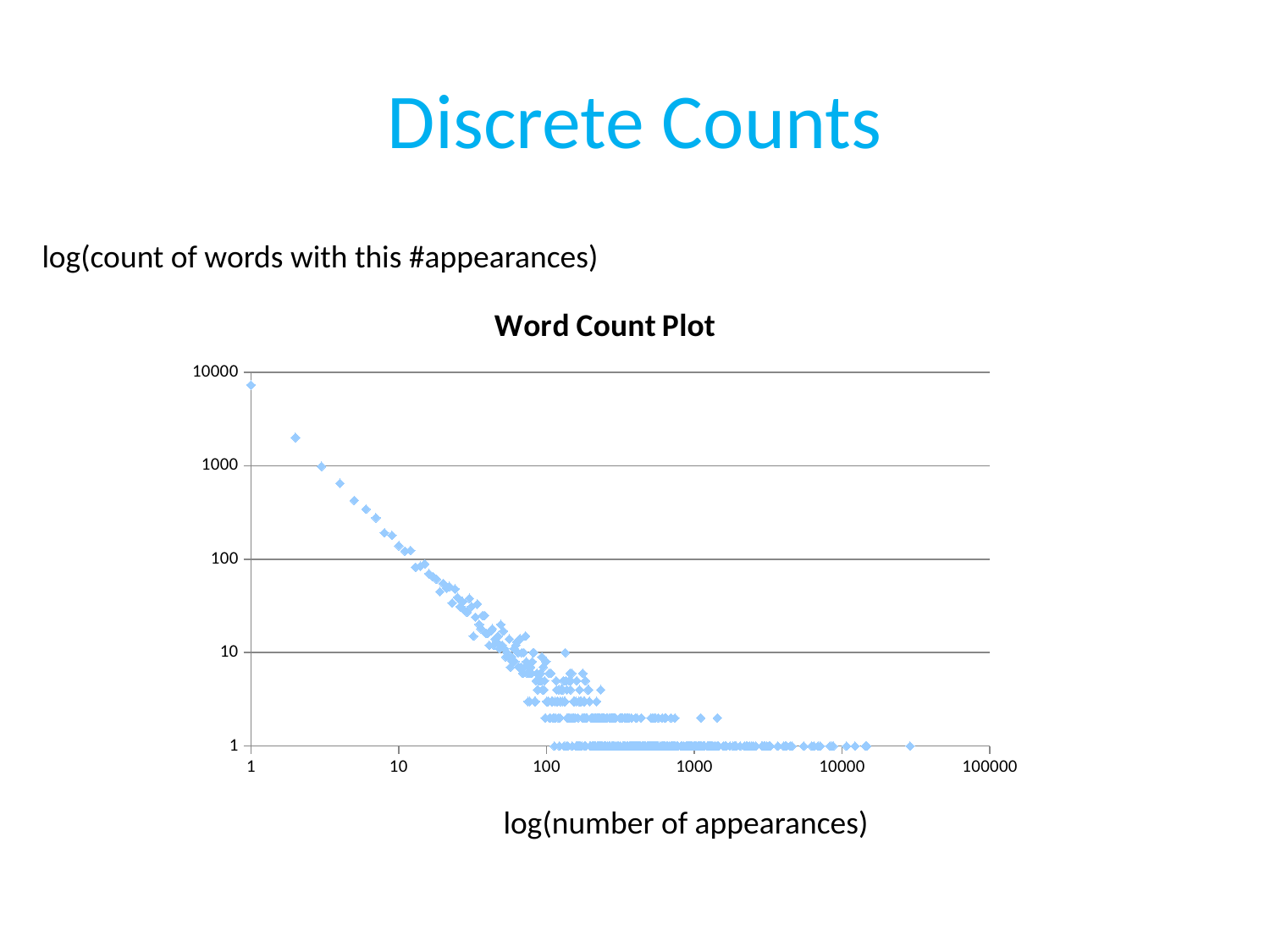
Which x value has the highest plotted count? 1 What is the label on the horizontal axis of the chart? log(number of appearances) Is the value for 1 appearance greater or less than 1000? greater Is the value for 10 appearances greater or less than 100? greater Is the value for 2 appearances greater or less than 1000? greater What kind of chart is shown on the slide? scatter plot Do the plotted values rise or fall as the number of appearances increases along the x axis? fall What is the title of the chart? Word Count Plot What is the highest tick value shown on the x axis? 100000